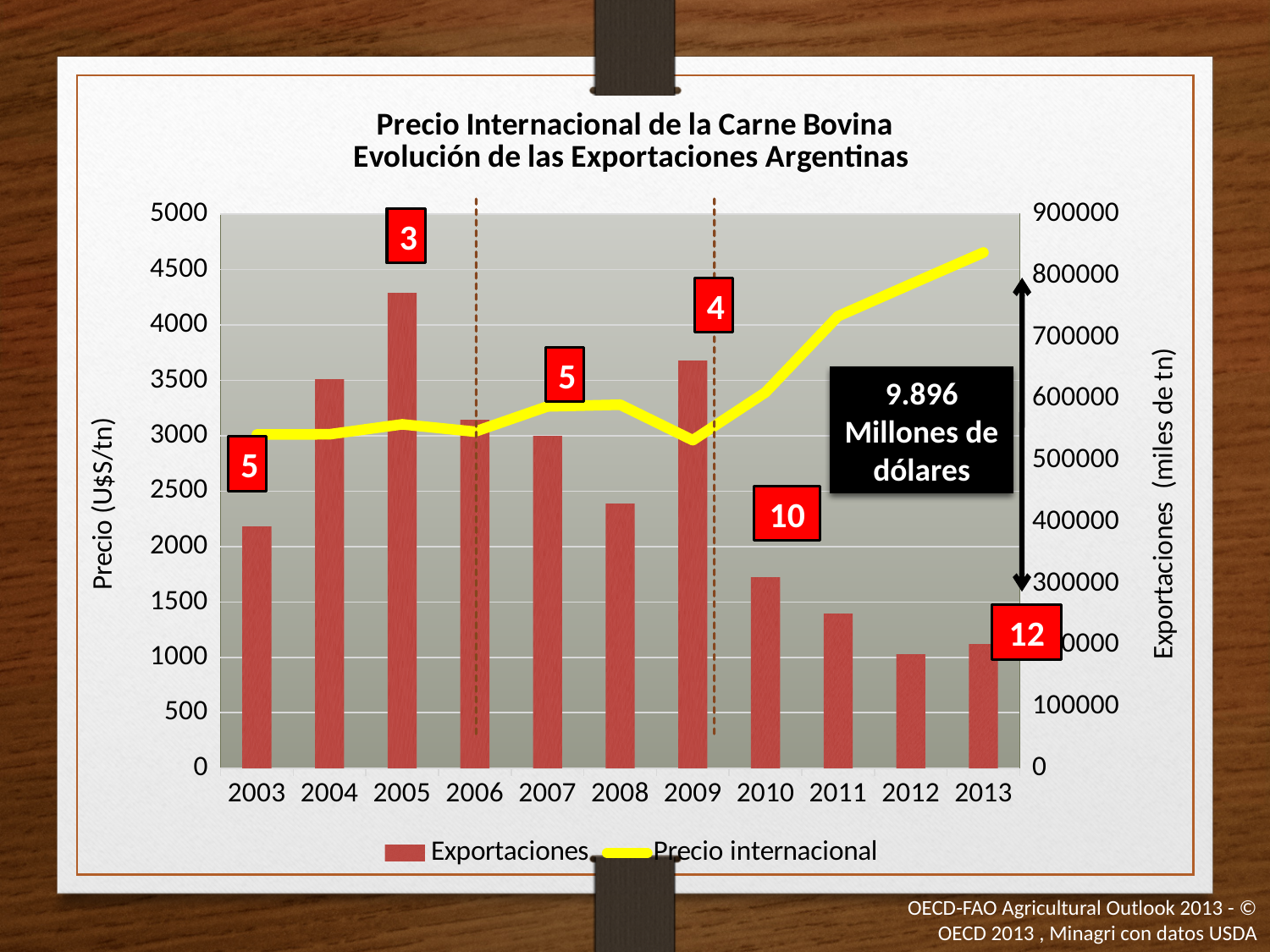
What kind of chart is shown on the slide? A combined bar and line chart Is the Exportaciones value for 2005 greater or less than 700000? greater What are the two entries in the chart legend? Exportaciones and Precio internacional Does the Precio internacional line rise or fall from 2009 to 2013? rise How many series does the legend list? 2 In which year is the Exportaciones bar the highest? 2005 Which year has the larger Exportaciones bar, 2005 or 2010? 2005 Is the Precio internacional value for 2013 greater or less than 4500? greater In which year does the Precio internacional line reach its highest value? 2013 How many years are shown on the x axis? 11 In which year is the Exportaciones bar the lowest? 2012